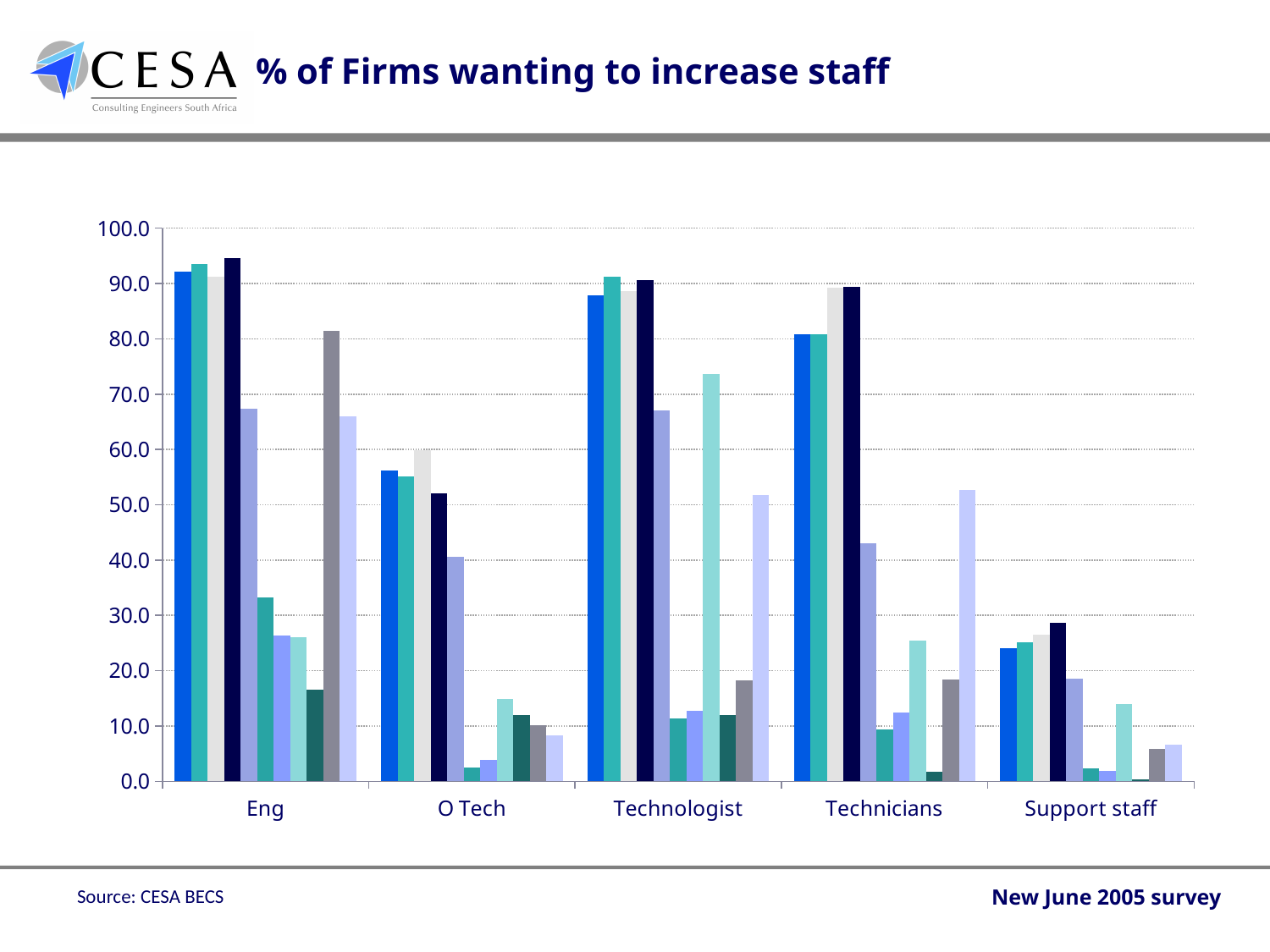
Is the value of the leftmost bar for Eng greater or less than 90? greater Is the value of the leftmost bar for Technologist greater or less than 80? greater How many categories are shown on the x axis of the chart? 5 Among the leftmost bars of each category, which category has the lowest value? Support staff Is the value of the leftmost bar for O Tech greater or less than 50? greater What is the highest value shown on the y axis of the chart? 100.0 What is the title of the chart on the slide? % of Firms wanting to increase staff Comparing the leftmost bars, which is larger: O Tech or Technologist? Technologist What kind of chart is shown on the slide? bar chart Comparing the leftmost bars, which is larger: Eng or Support staff? Eng